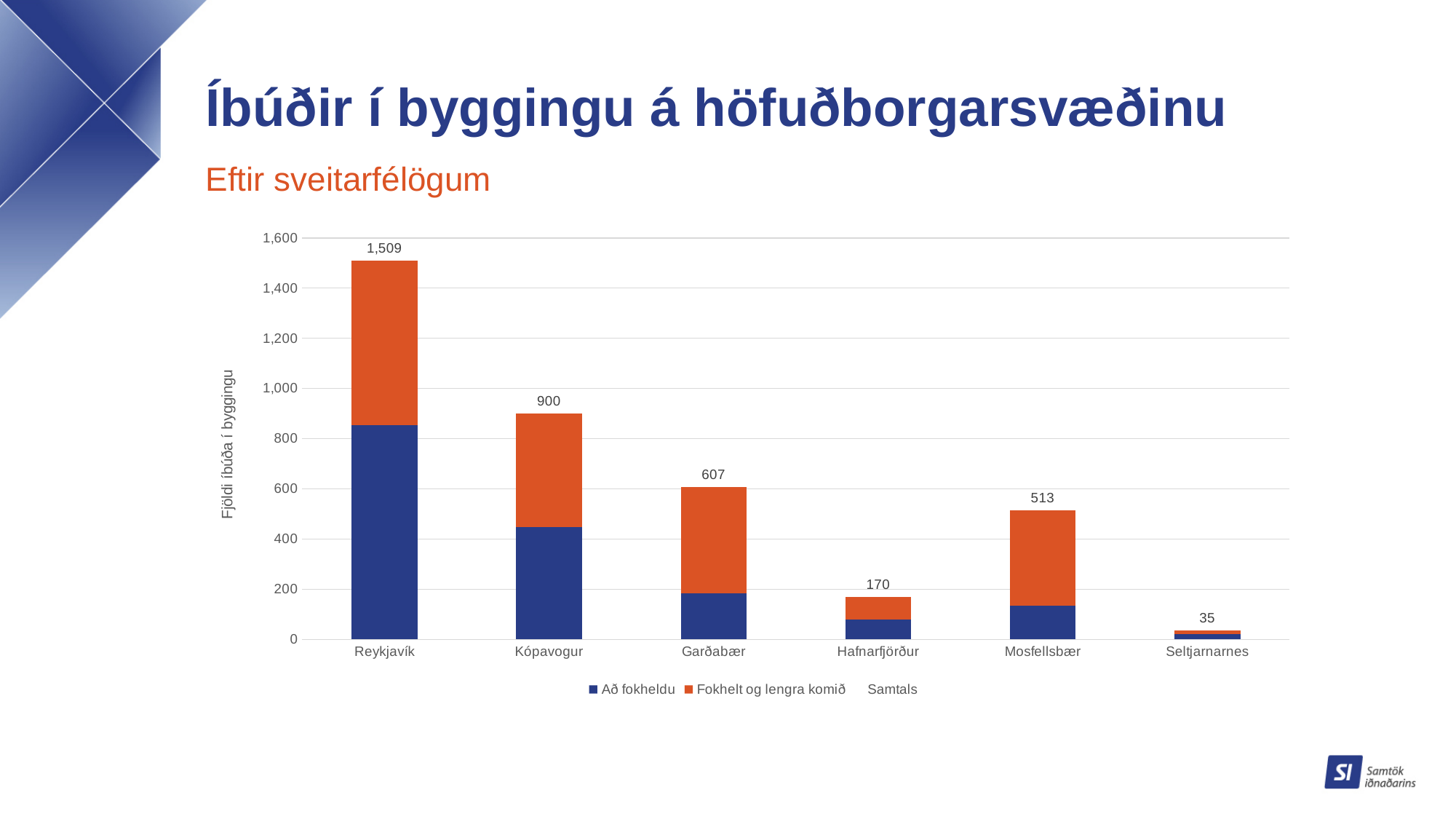
Is the 'Að fokheldu' value for Garðabær greater or less than 200? less Which municipality has the highest total number of apartments under construction? Reykjavík What is the total number of apartments under construction (Samtals) for Reykjavík? 1,509 How many municipalities are shown on the x axis? 6 What is the total value shown for Mosfellsbær? 513 Which municipality has the lowest total number of apartments under construction? Seltjarnarnes What is the difference between the totals for Reykjavík and Kópavogur? 609 How many entries does the legend list? 3 Which has a larger total, Hafnarfjörður or Mosfellsbær? Mosfellsbær Is the 'Að fokheldu' value for Reykjavík greater or less than 800? greater What is the total value shown for Kópavogur? 900 What is the difference between the totals for Garðabær and Mosfellsbær? 94